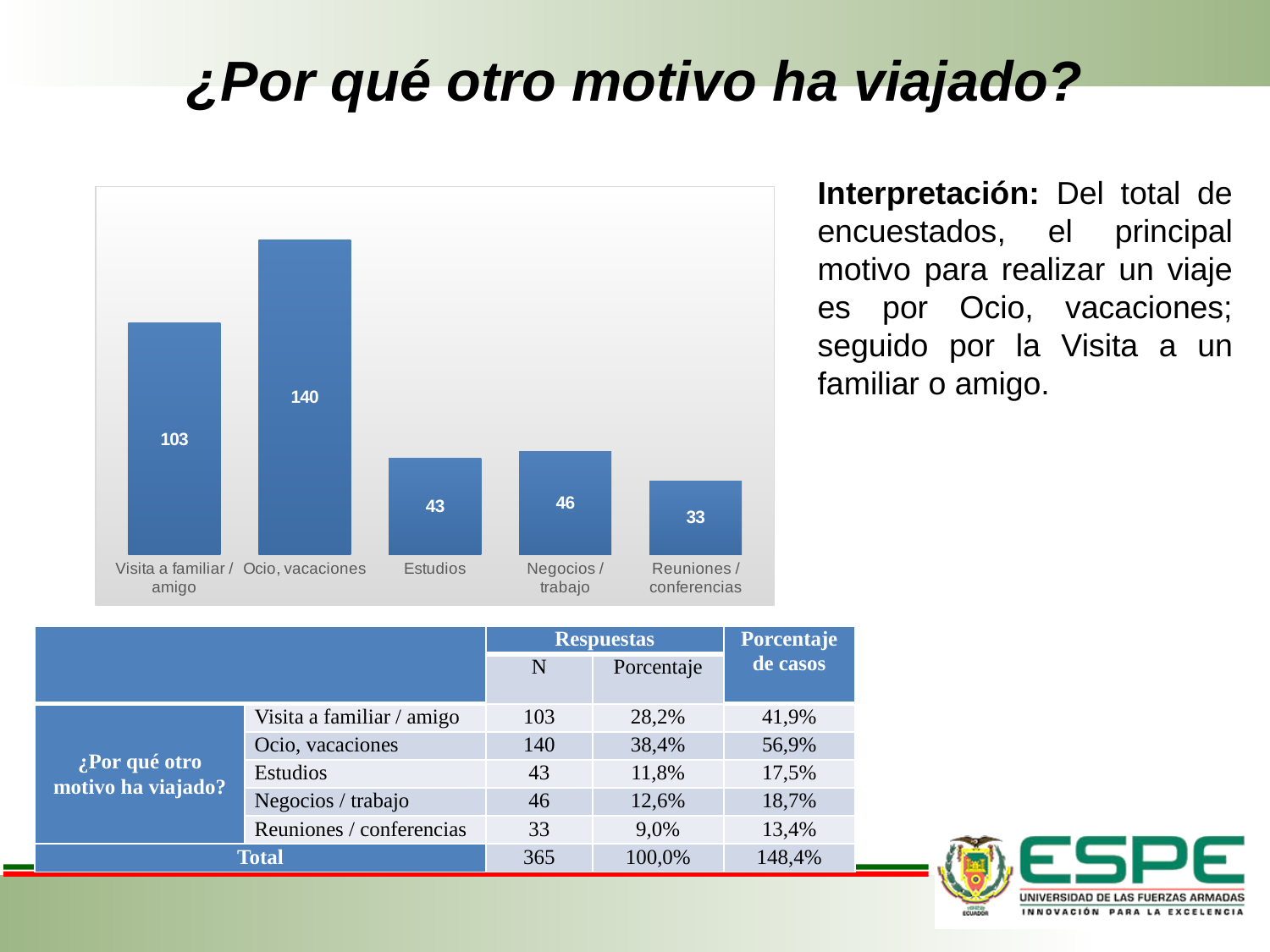
What is the value for Visita a familiar / amigo? 103 What is the value for Estudios? 43 How many categories are shown in the chart? 5 What is the difference between the values for Negocios / trabajo and Estudios? 3 Which is larger, the value for Negocios / trabajo or the value for Estudios? Negocios / trabajo What is the difference between the values for Ocio, vacaciones and Visita a familiar / amigo? 37 Which category has the lowest value? Reuniones / conferencias What is the total of all the values shown in the chart? 365 What kind of chart is shown on the slide? bar chart Which category has the highest value? Ocio, vacaciones What is the value for Ocio, vacaciones? 140 What is the value for Reuniones / conferencias? 33